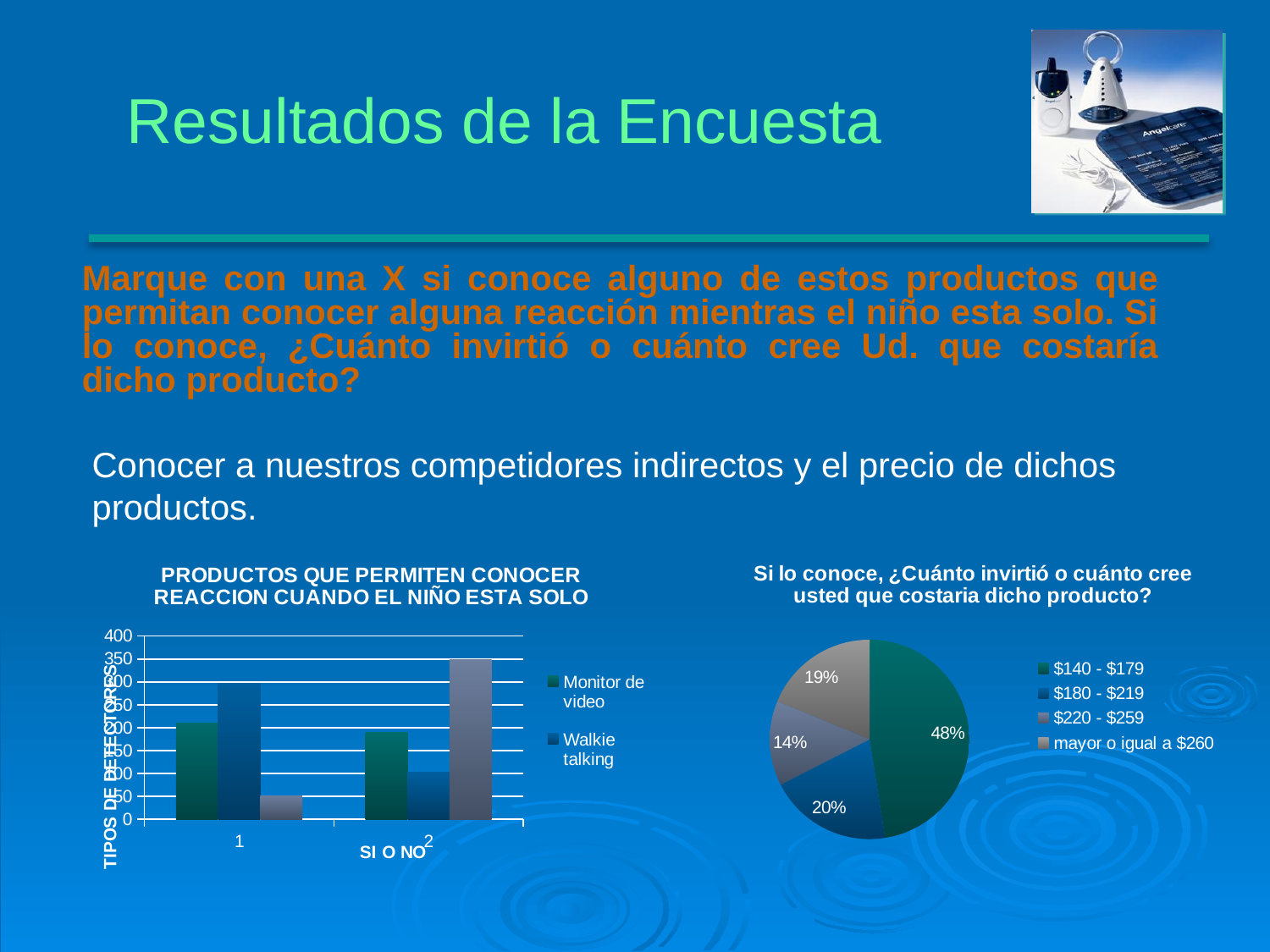
What kind of chart is 'PRODUCTOS QUE PERMITEN CONOCER REACCION CUANDO EL NIÑO ESTA SOLO'? Bar chart In the pie chart on the right, what percentage corresponds to $220 - $259? 14% What kind of chart is the chart on the right of the slide? Pie chart In the pie chart 'Si lo conoce, ¿Cuánto invirtió o cuánto cree usted que costaria dicho producto?', what percentage corresponds to $140 - $179? 48% How many slices does the pie chart on the right have? 4 In the bar chart on the left, how many series does the legend list? 2 In the pie chart on the right, which price range has the largest share? $140 - $179 In the bar chart on the left, is the value for 'Walkie talking' in category 2 greater or less than 150? less In the bar chart on the left, is the value for 'Walkie talking' in category 1 greater or less than 250? greater In the pie chart on the right, which is larger: the share for $180 - $219 or the share for 'mayor o igual a $260'? $180 - $219 In the pie chart on the right, which price range has the smallest share? $220 - $259 In the pie chart on the right, what is the difference in percentage points between the $140 - $179 slice and the $180 - $219 slice? 28